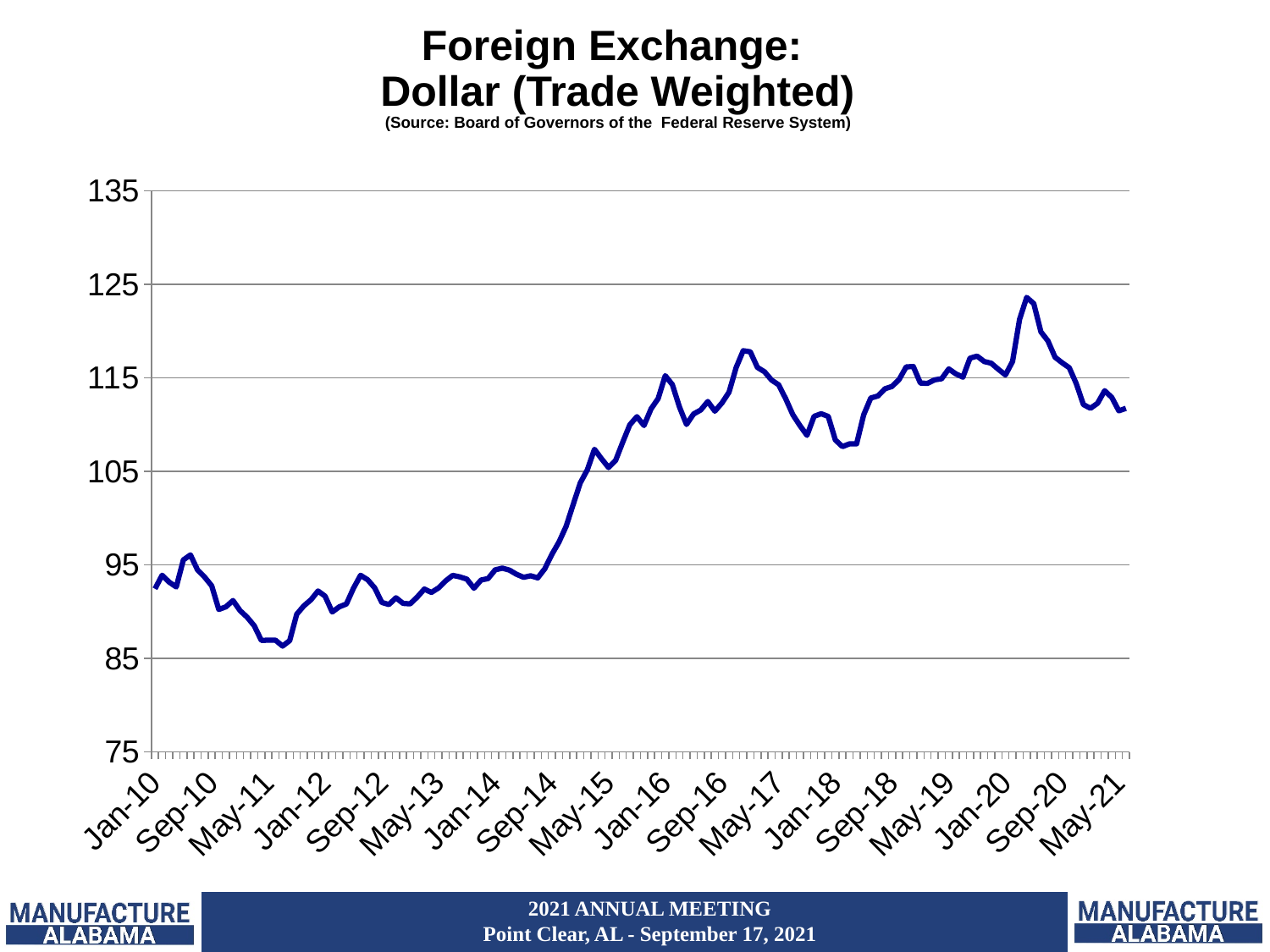
Is the value for May-21 greater or less than 115? less Which is larger, the value for Sep-10 or the value for May-11? Sep-10 What kind of chart is shown on the slide? line chart Which is larger, the value for Jan-12 or the value for Jan-16? Jan-16 Is the value for Jan-10 greater or less than 95? less Is the value for May-11 greater or less than 95? less What is the title of the chart? Foreign Exchange: Dollar (Trade Weighted) How many date labels are shown along the x axis? 18 Does the line rise or fall between Sep-14 and May-15? rise Overall, does the trade-weighted dollar index rise or fall from Jan-10 to May-21? rise What source is cited for the chart data? Board of Governors of the Federal Reserve System